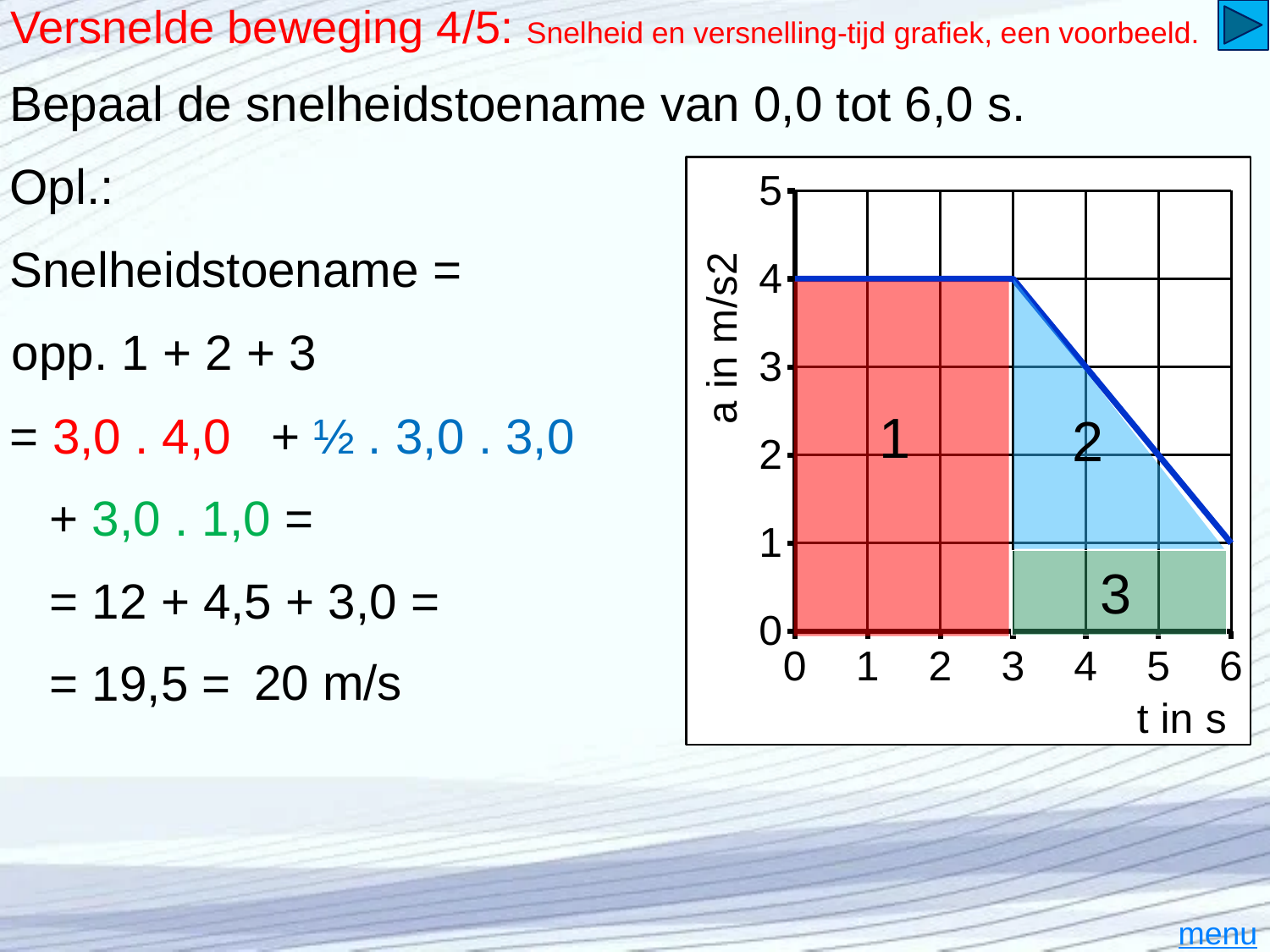
Which is larger, the value of a at t = 2 s or at t = 5 s? t = 2 s Does the value of a rise or fall along the t axis between t = 3 s and t = 6 s? fall What is the value of a at t = 4 s? 3 What is the value of a at t = 6 s? 1 What is the value of a at t = 3 s? 4 What is the label of the vertical axis? a in m/s2 What is the value of a at t = 0 s? 4 How many numbered shaded areas are marked under the line? 3 What is the difference between the value of a at t = 3 s and at t = 6 s? 3 Is the value of a at t = 1 s greater or less than 3? greater What is the value of a at t = 5 s? 2 What kind of chart is shown on the slide? line chart